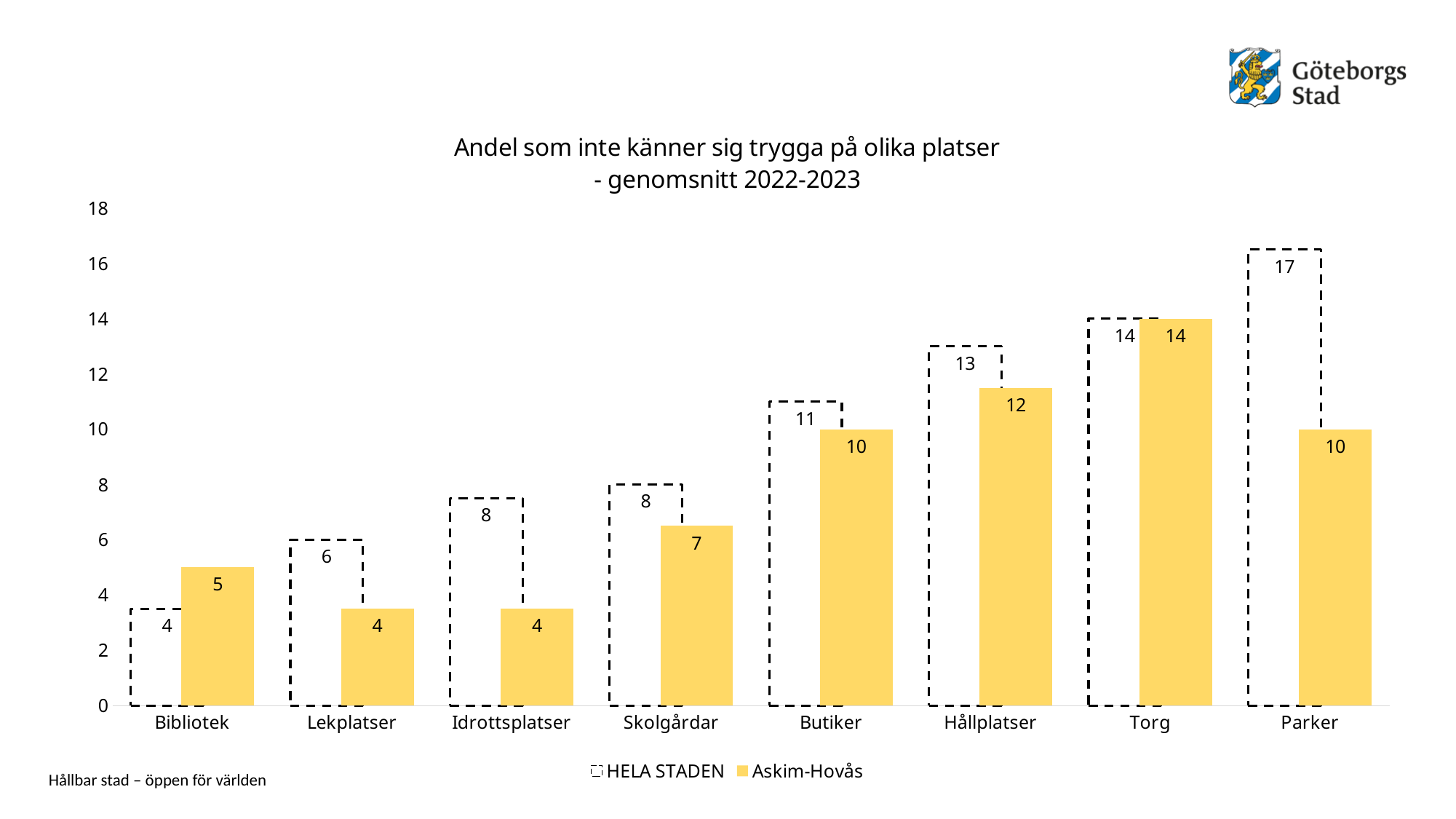
How many categories are shown on the x axis? 8 What is the difference between HELA STADEN and Askim-Hovås at Parker? 7 Which series is drawn with a dashed outline? HELA STADEN Which category has the lowest value for HELA STADEN? Bibliotek Which category has the highest value for Askim-Hovås? Torg How many series does the legend list? 2 What is the value for Askim-Hovås at Skolgårdar? 7 Which is larger at Bibliotek, HELA STADEN or Askim-Hovås? Askim-Hovås What is the value for HELA STADEN at Hållplatser? 13 What is the value for Askim-Hovås at Parker? 10 Which category has the highest value for HELA STADEN? Parker What kind of chart is shown on the slide? Bar chart